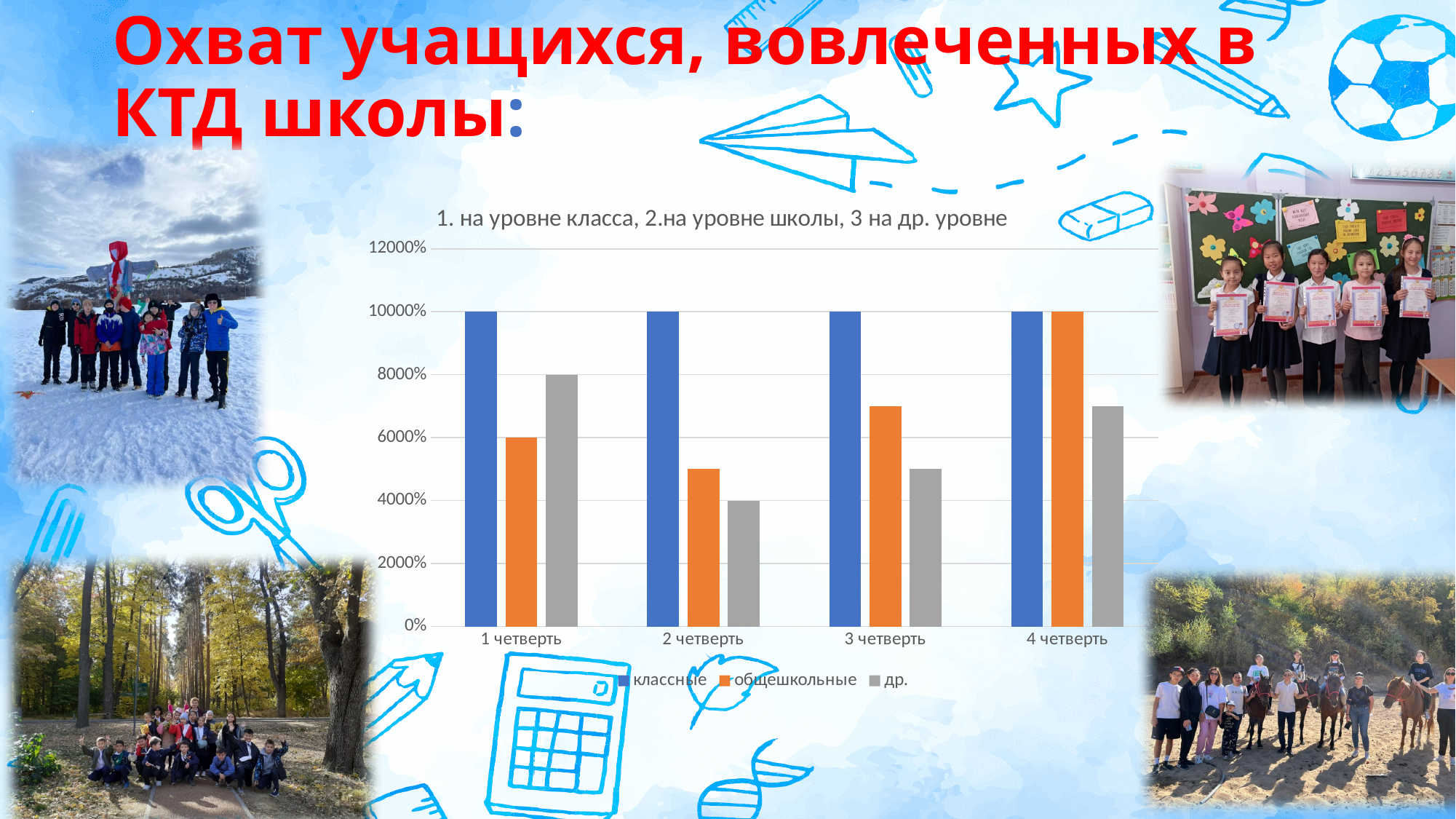
Is the value for общешкольные in 3 четверть greater or less than 6000%? greater What is the value for классные in 1 четверть? 10000% What kind of chart is shown on the slide? bar chart In which quarter is the value for др. the lowest? 2 четверть How many series does the chart legend list? 3 What is the value for общешкольные in 4 четверть? 10000% Which is larger in 2 четверть: общешкольные or др.? общешкольные What is the value for общешкольные in 1 четверть? 6000% How many categories are shown on the x axis of the chart? 4 What is the value for др. in 1 четверть? 8000% Is the value for др. in 3 четверть greater or less than 6000%? less What is the value for др. in 2 четверть? 4000%